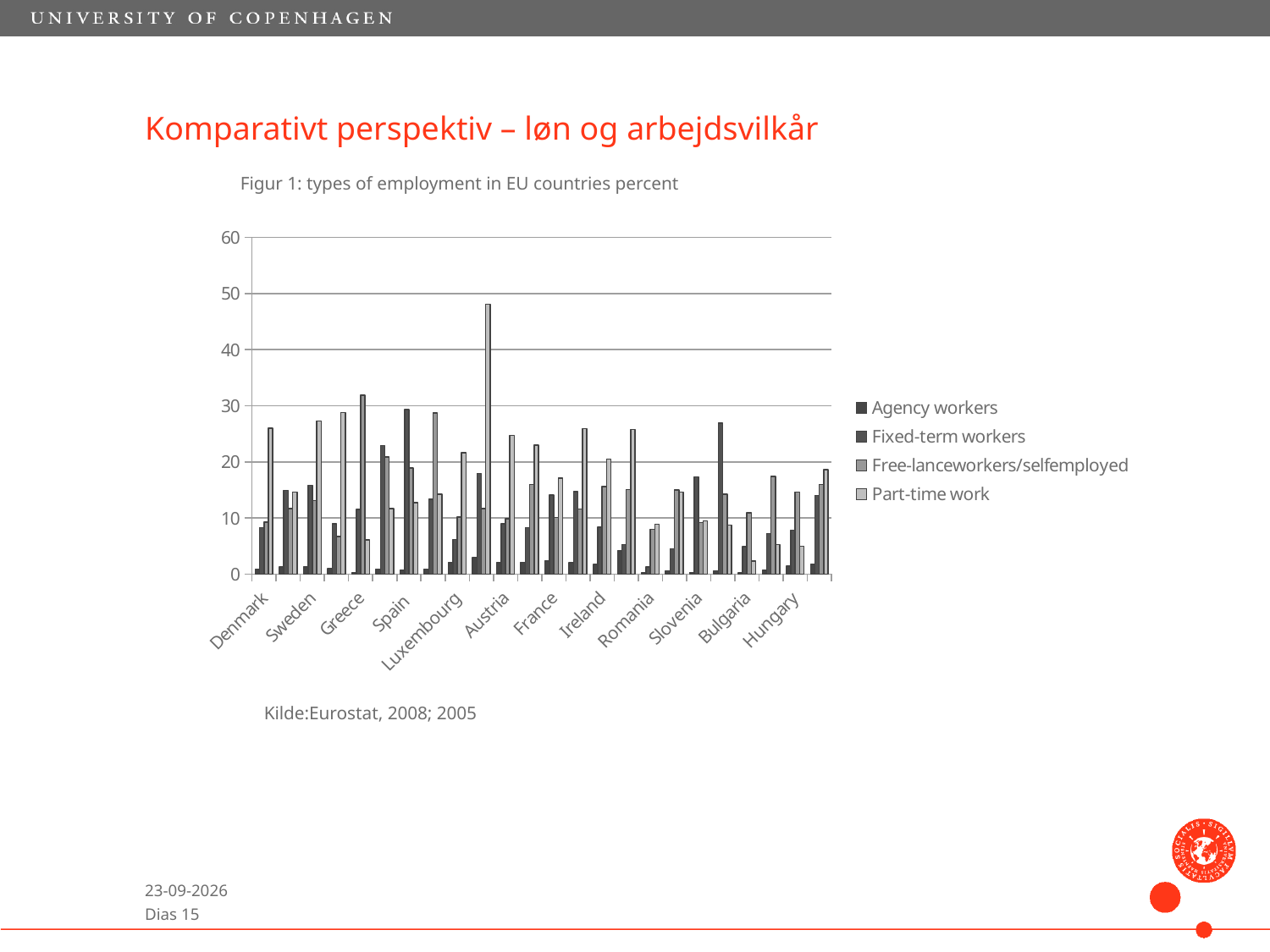
How many series does the legend list? 4 In Denmark, which is larger: Part-time work or Fixed-term workers? Part-time work What is the highest value shown on the y axis? 60 What is the title of the chart? Figur 1: types of employment in EU countries percent What kind of chart is shown on the slide? bar chart Which series has the highest value for Denmark? Part-time work Is the value for Agency workers in Denmark greater or less than 10? less Which series has the lowest value for Denmark? Agency workers Is the value for Part-time work in Denmark greater or less than 20? greater Which series is listed last in the legend? Part-time work